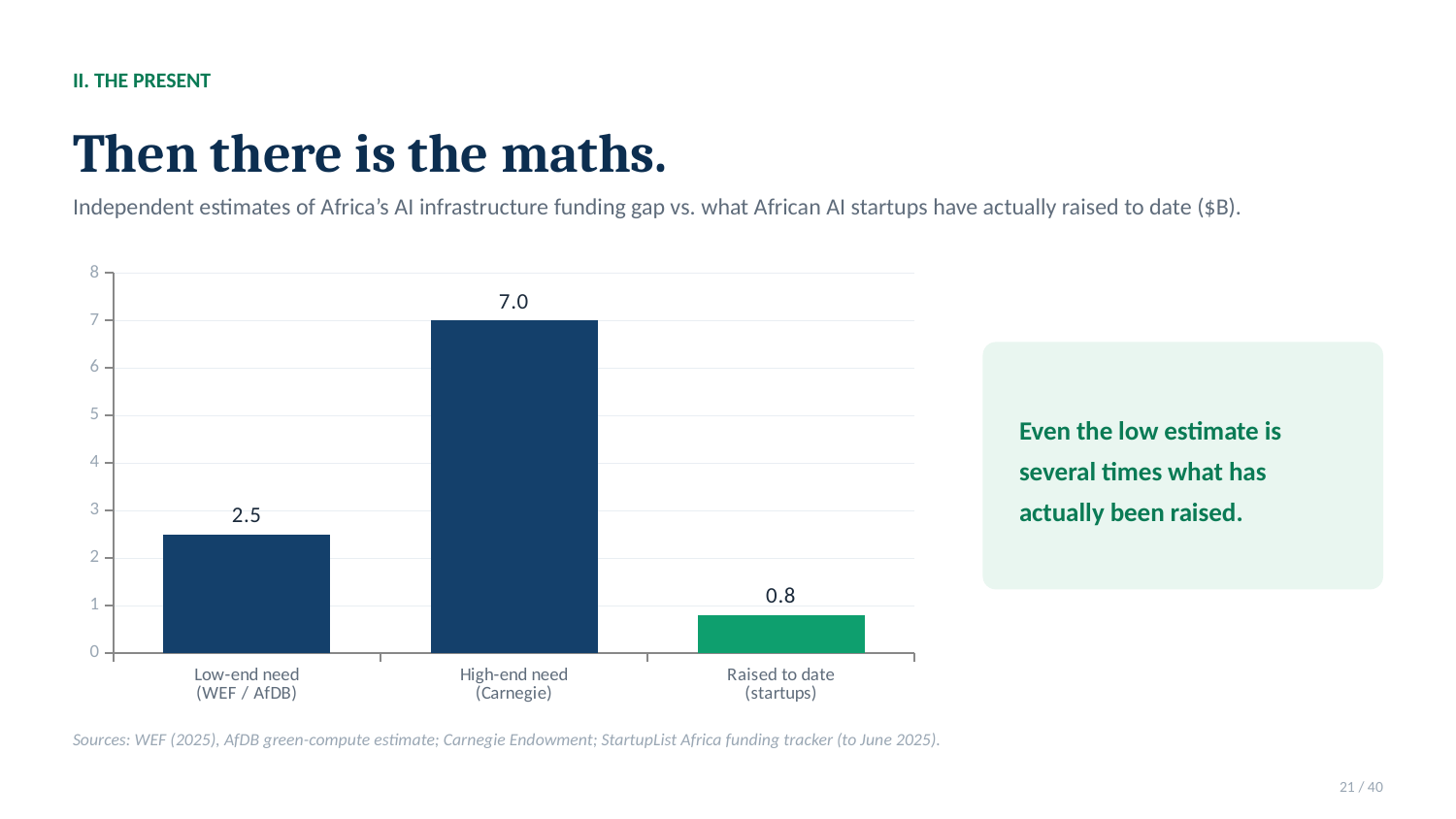
How many categories are shown in the chart? 3 What is the value for Raised to date (startups)? 0.8 What kind of chart is shown on the slide? Bar chart Which category has the lowest value? Raised to date (startups) What is the difference between the Low-end need (WEF / AfDB) and Raised to date (startups)? 1.7 Which is larger, Low-end need (WEF / AfDB) or Raised to date (startups)? Low-end need (WEF / AfDB) What is the difference between the High-end need (Carnegie) and the Low-end need (WEF / AfDB)? 4.5 Which category has the highest value? High-end need (Carnegie) What is the value for Low-end need (WEF / AfDB)? 2.5 Which bar is shown in a different colour (green) from the others? Raised to date (startups) What is the value for High-end need (Carnegie)? 7.0 Is the value for High-end need (Carnegie) greater or less than 6? greater